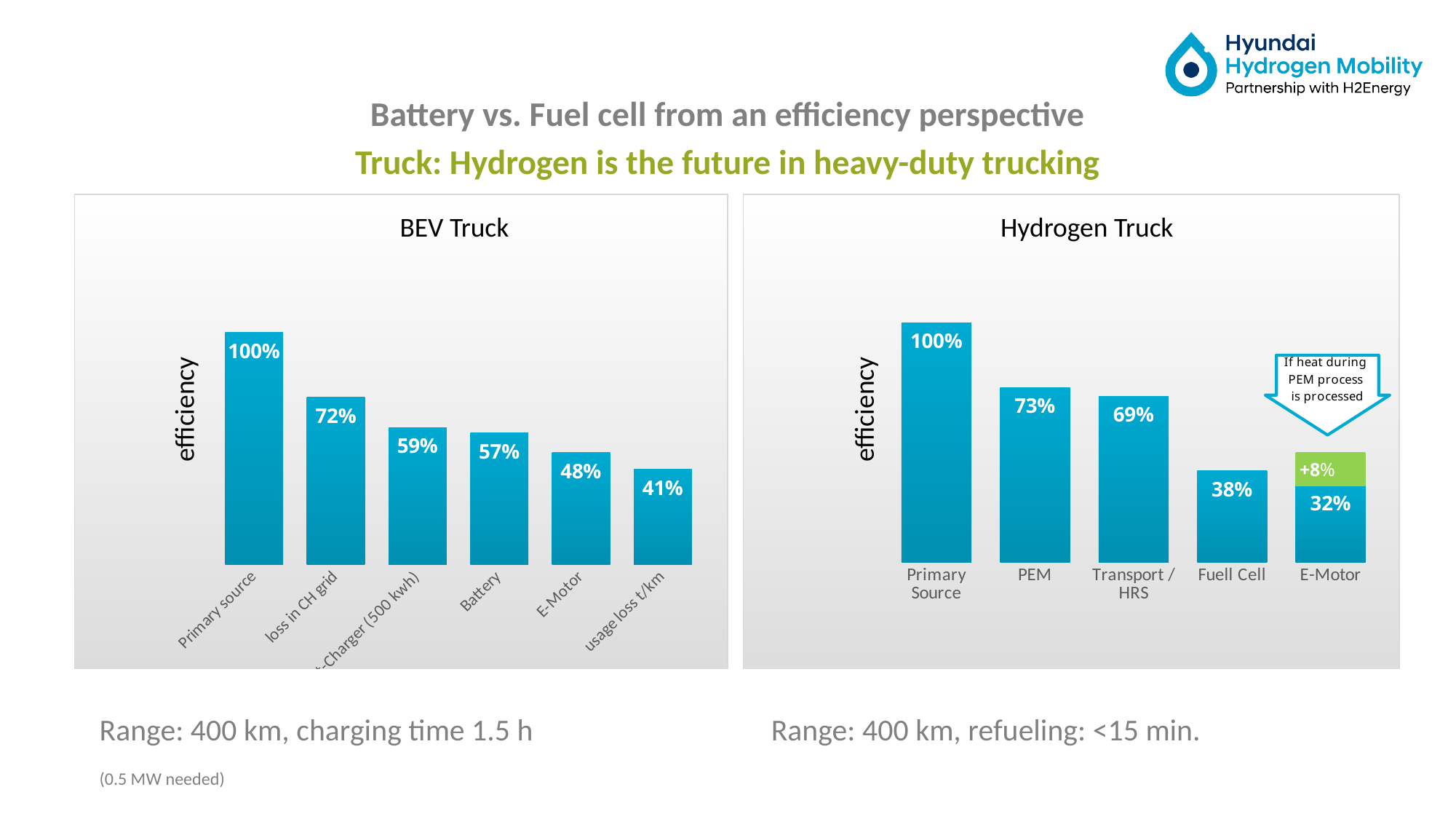
In the BEV Truck chart, what is the difference between the loss in CH grid value and the Battery value? 15% Which is larger: the E-Motor value in the BEV Truck chart or the blue E-Motor value in the Hydrogen Truck chart? BEV Truck In the Hydrogen Truck chart, which category has the lowest blue bar? E-Motor In the Hydrogen Truck chart, what is the total of the E-Motor bar including the green +8% segment? 40% In the Hydrogen Truck chart, what is the value for PEM? 73% In the Hydrogen Truck chart, what is the value for Transport / HRS? 69% What type of chart is the BEV Truck chart? Bar chart In the BEV Truck chart, what is the value for usage loss t/km? 41% In the BEV Truck chart, what is the value for E-Motor? 48% How many bars are in the Hydrogen Truck chart? 5 In the BEV Truck chart, what is the efficiency value for Battery? 57% In the Hydrogen Truck chart, what is the blue value for E-Motor? 32%